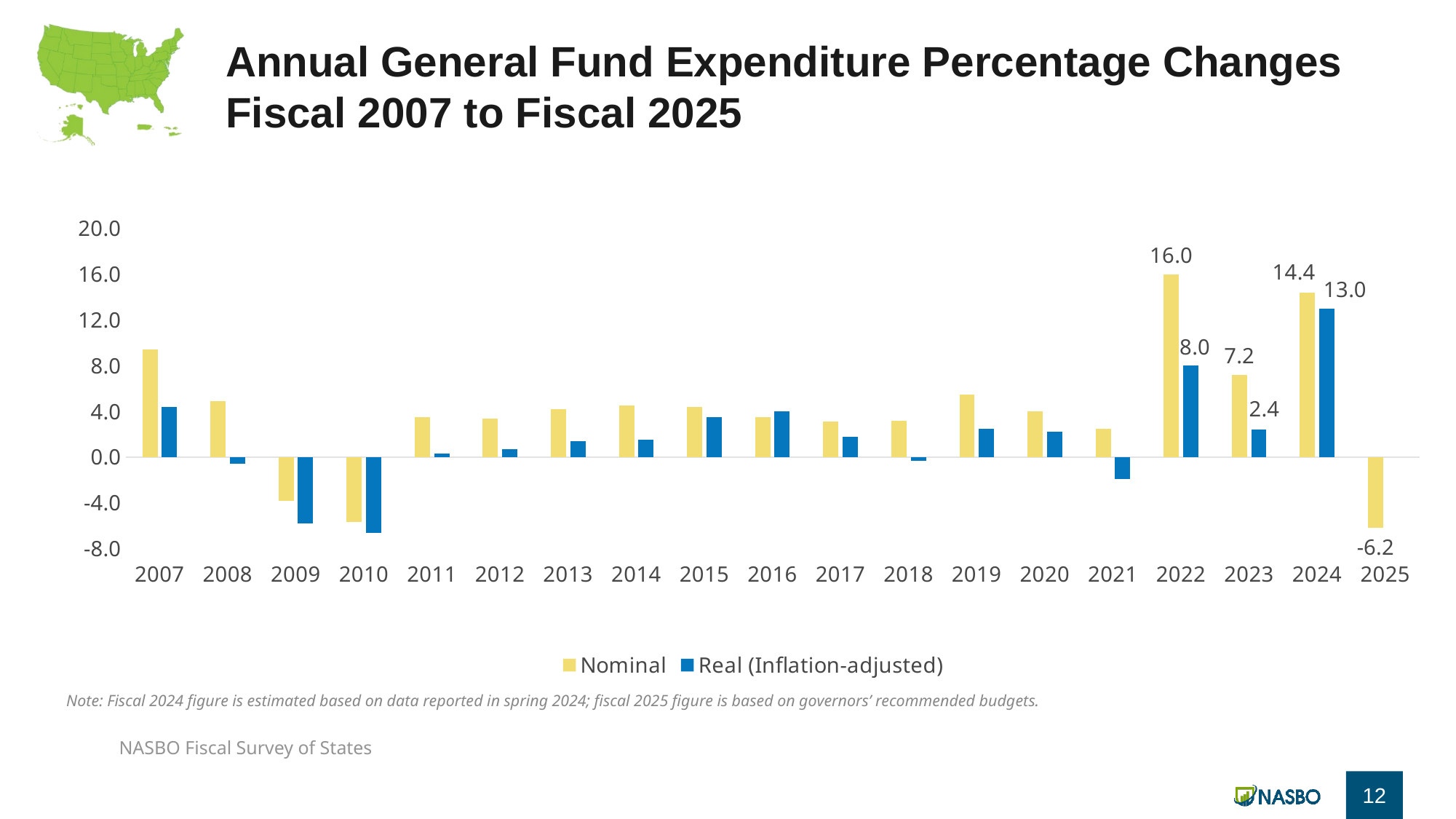
What is the Nominal value for 2022? 16.0 What is the difference between the Nominal and Real (Inflation-adjusted) values for 2024? 1.4 What is the difference between the Nominal and Real (Inflation-adjusted) values for 2022? 8.0 How many years are shown on the x axis? 19 Which year has the larger Real (Inflation-adjusted) value, 2022 or 2024? 2024 Is the Nominal value for 2007 greater or less than 8.0? greater How many series does the legend list? 2 Which year has the lowest Nominal value? 2025 Which year has the highest Nominal value? 2022 What is the Nominal value for 2025? -6.2 What is the Real (Inflation-adjusted) value for 2023? 2.4 What is the Real (Inflation-adjusted) value for 2024? 13.0